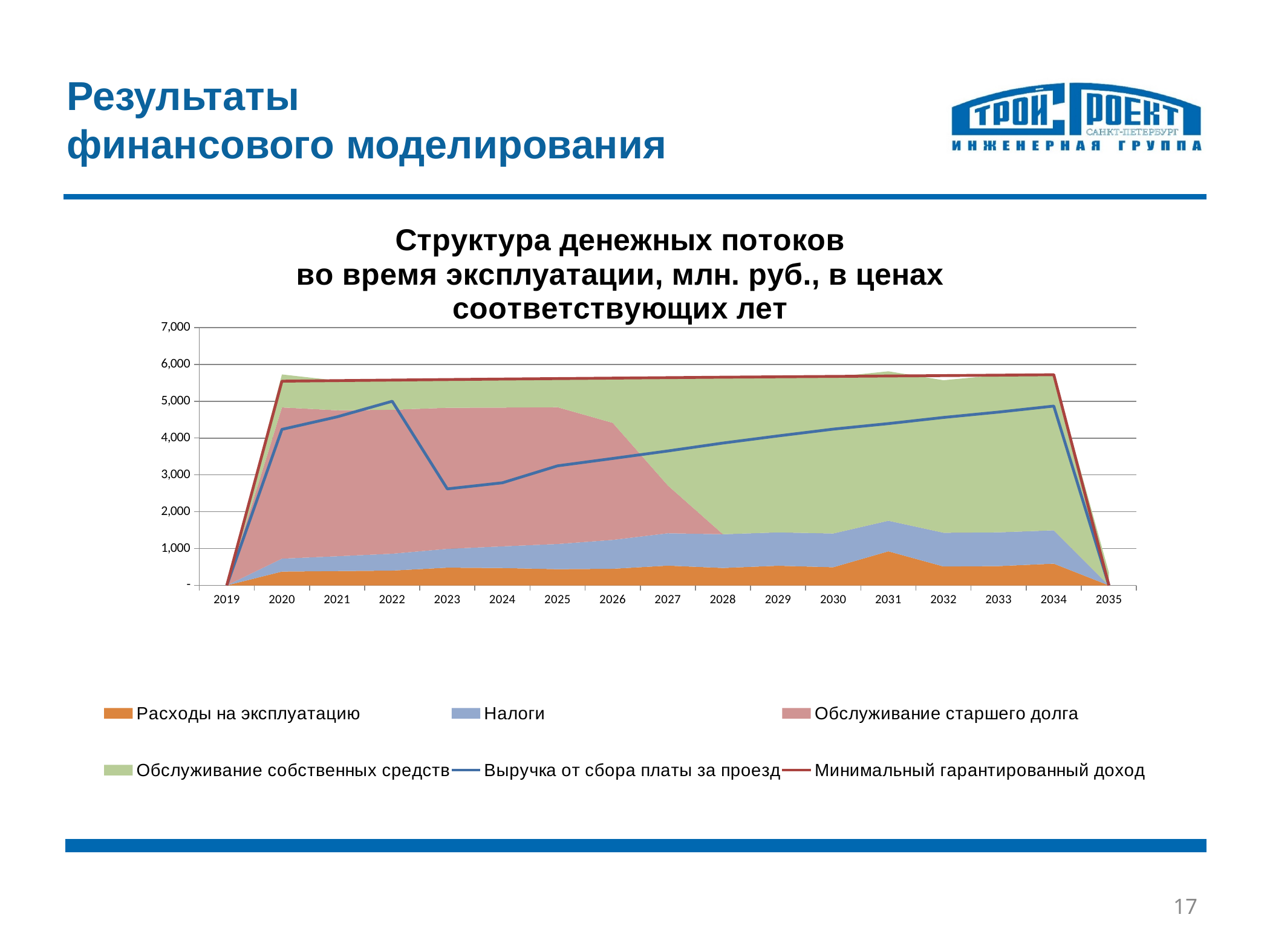
What is the first year shown on the x axis? 2019 Does Выручка от сбора платы за проезд rise or fall from 2023 to 2034? rise How many years are shown on the x axis? 17 Is the value of Минимальный гарантированный доход in 2025 greater or less than 6,000? less Is the value of Выручка от сбора платы за проезд in 2023 greater or less than 3,000? less Is the value of Выручка от сбора платы за проезд in 2034 greater or less than 4,000? greater Between 2020 and 2034, in which year is Выручка от сбора платы за проезд lowest? 2023 Which series is drawn as a red line? Минимальный гарантированный доход Which is larger, Выручка от сбора платы за проезд in 2022 or in 2023? 2022 What kind of chart is this? Stacked area chart with line series How many series does the legend list? 6